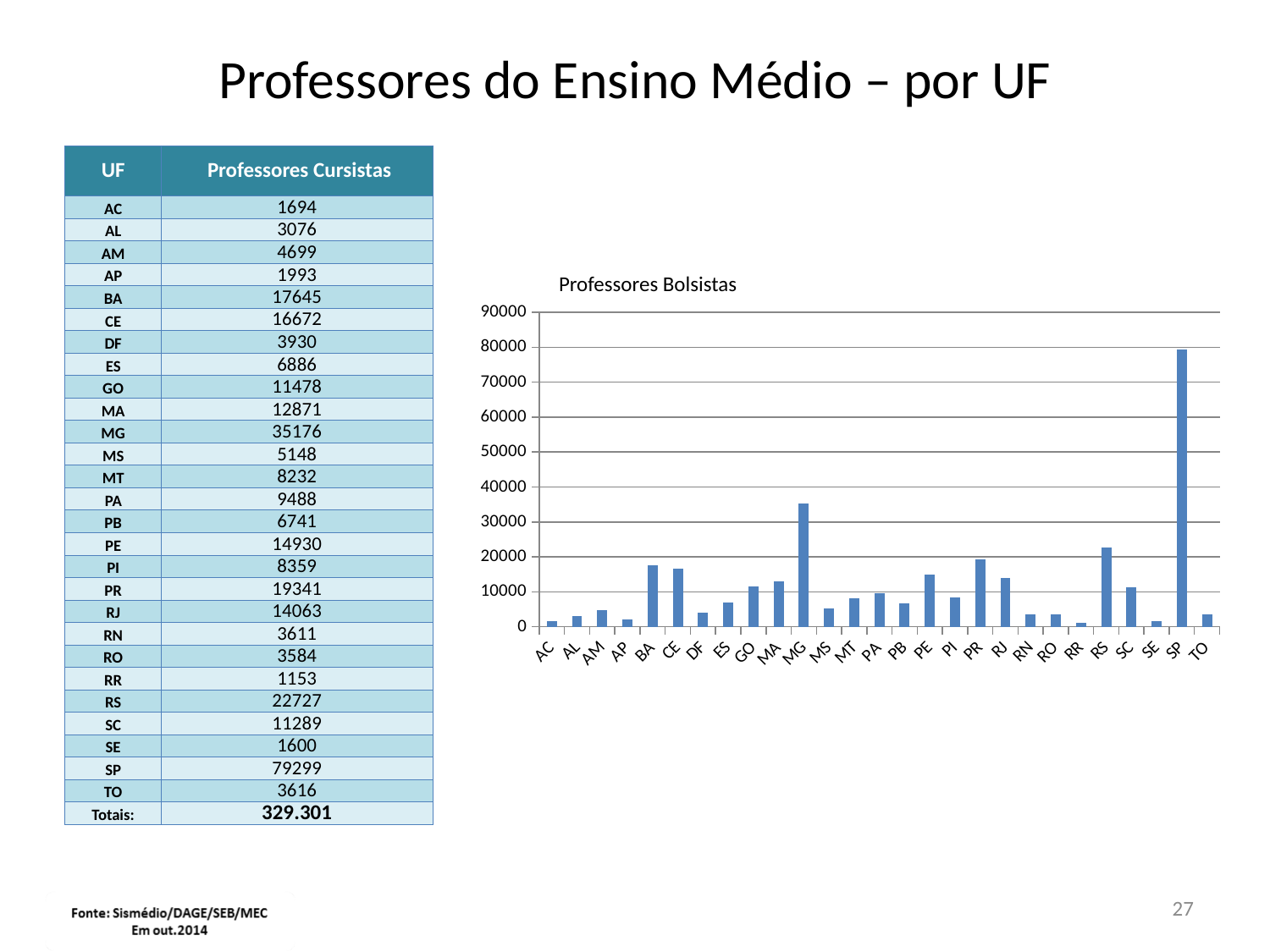
What kind of chart is shown on the slide? bar chart Which has the larger bar, MG or RS? MG Is the value for SP greater or less than 70000? greater Which UF has the lowest bar in the chart? RR According to the table on the slide, what is the number of Professores Cursistas for SP? 79299 What is the title of the chart? Professores Bolsistas Which has the larger bar, PR or RJ? PR How many UF categories are plotted along the x axis of the chart? 27 Is the value for MG greater or less than 30000? greater Is the value for AC greater or less than 10000? less Which UF has the highest bar in the chart? SP